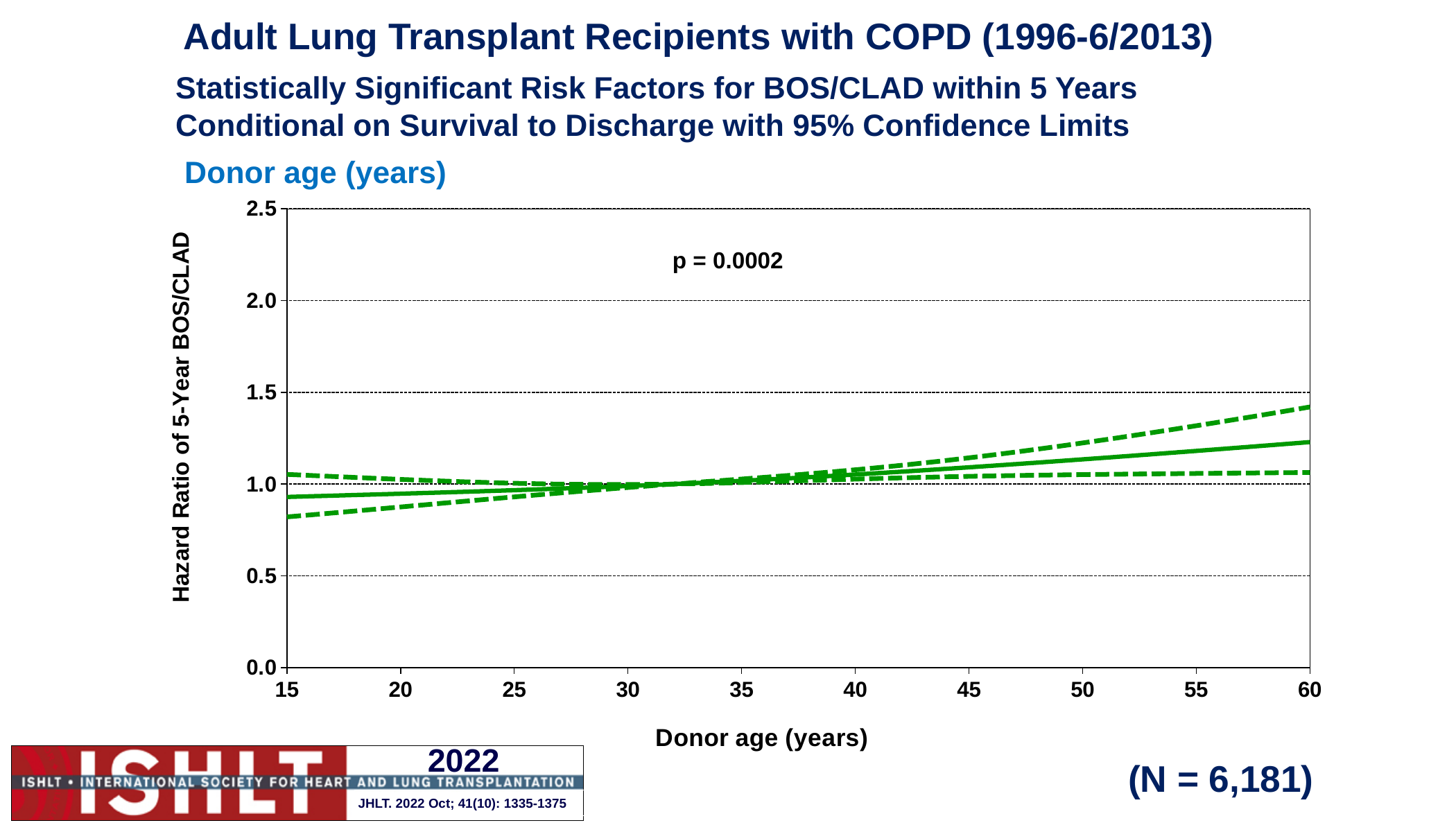
Is the hazard ratio (solid line) at donor age 15 greater or less than 1.0? less Is the upper 95% confidence limit (upper dashed line) at donor age 60 greater or less than 1.5? less What is the lowest donor age shown on the x axis? 15 Does the hazard ratio (solid line) rise or fall as donor age increases from 15 to 60 years? rise What is the label of the y axis? Hazard Ratio of 5-Year BOS/CLAD What p-value is printed on the chart? p = 0.0002 Is the hazard ratio (solid line) at donor age 60 greater or less than 1.0? greater How many lines are plotted on the chart? 3 What kind of chart is shown on the slide? line chart Is the hazard ratio (solid line) higher at donor age 60 or at donor age 15? donor age 60